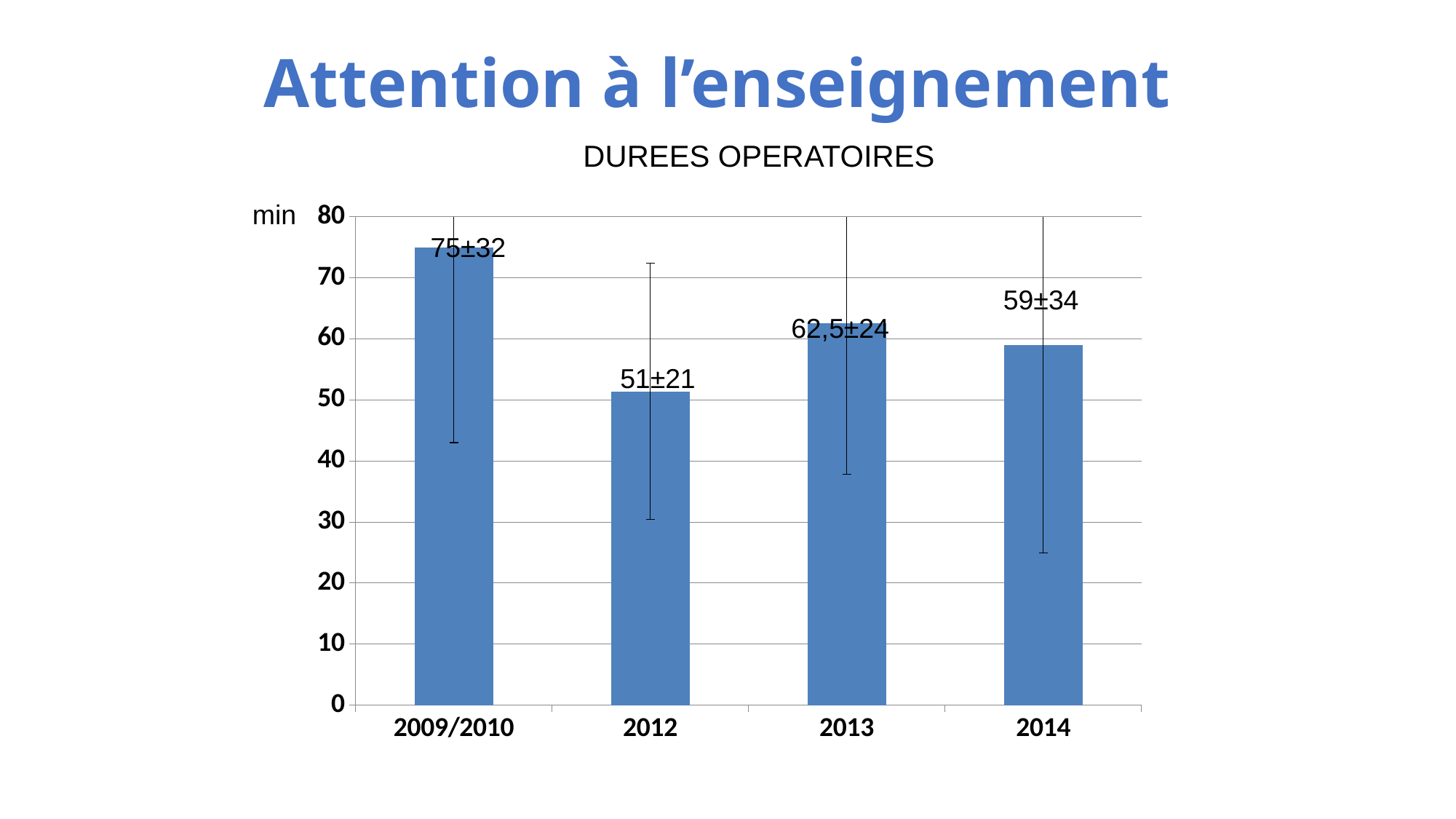
What is the data label shown for 2012? 51±21 What is the data label shown for 2009/2010? 75±32 What is the data label shown for 2013? 62,5±24 Which category has the highest mean operative duration? 2009/2010 How many categories are shown on the x axis? 4 Which category has the lowest mean operative duration? 2012 What is the data label shown for 2014? 59±34 What kind of chart is shown on the slide? bar chart What is the title of the chart? DUREES OPERATOIRES What is the difference between the mean values for 2009/2010 and 2012? 24 Is the mean value for 2014 greater or less than 60? less Which has a larger mean value, 2013 or 2014? 2013